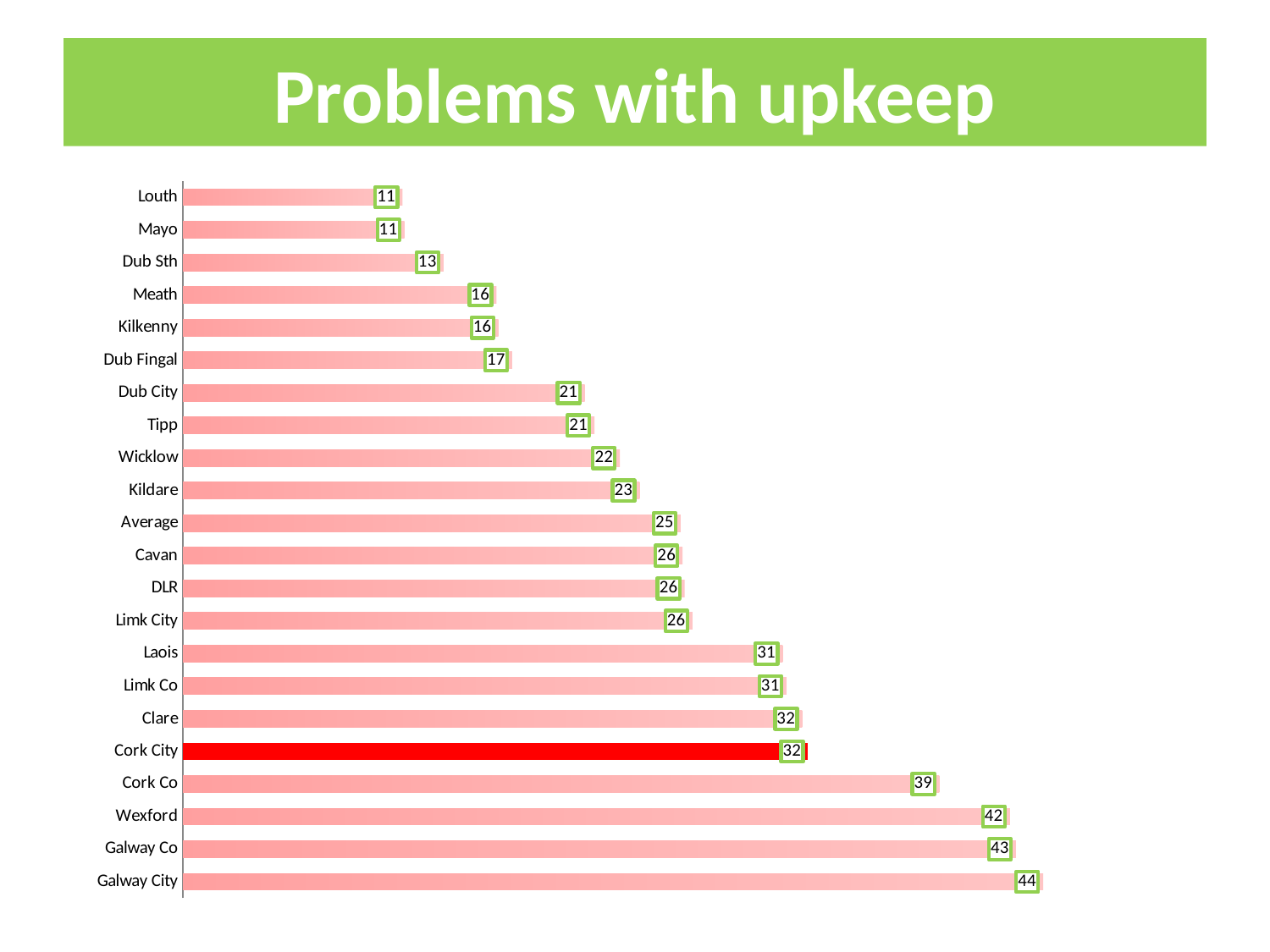
How many categories are shown on the chart? 22 What is the value for Cork City? 32 Which is larger, the value for Laois or the value for Kildare? Laois What kind of chart is this? Bar chart What is the difference between the values for Galway City and Louth? 33 What is the value for Wexford? 42 What is the title of the slide? Problems with upkeep Which category has the lowest value, Louth or Dub Sth? Louth What is the difference between the values for Cork Co and Cork City? 7 What is the value shown for Average? 25 Which category has the highest value? Galway City Which bar is highlighted in a different colour (red) from the others? Cork City